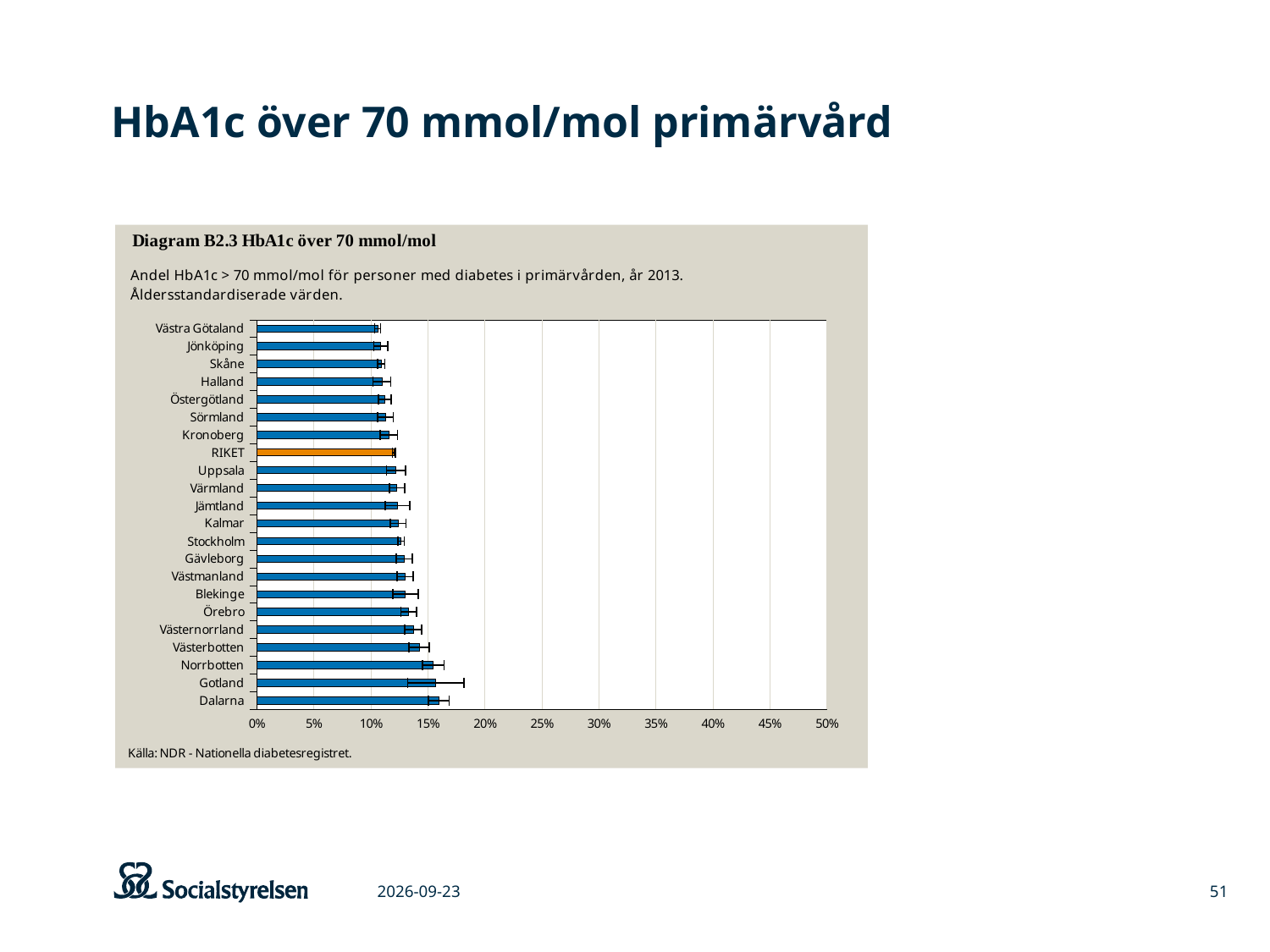
Which has the larger value, Dalarna or Västra Götaland? Dalarna Is the value for Norrbotten greater or less than 20%? less What is the title of the diagram shown in the chart box? Diagram B2.3 HbA1c över 70 mmol/mol What kind of chart is shown on the slide? bar chart How many categories (bars) are plotted in the chart? 22 Is the value for Västra Götaland greater or less than 15%? less Which category's bar is coloured orange instead of blue? RIKET Is the value for RIKET greater or less than 10%? greater Which has the larger value, Norrbotten or Skåne? Norrbotten Do the bar values increase or decrease going from the top category to the bottom category? increase